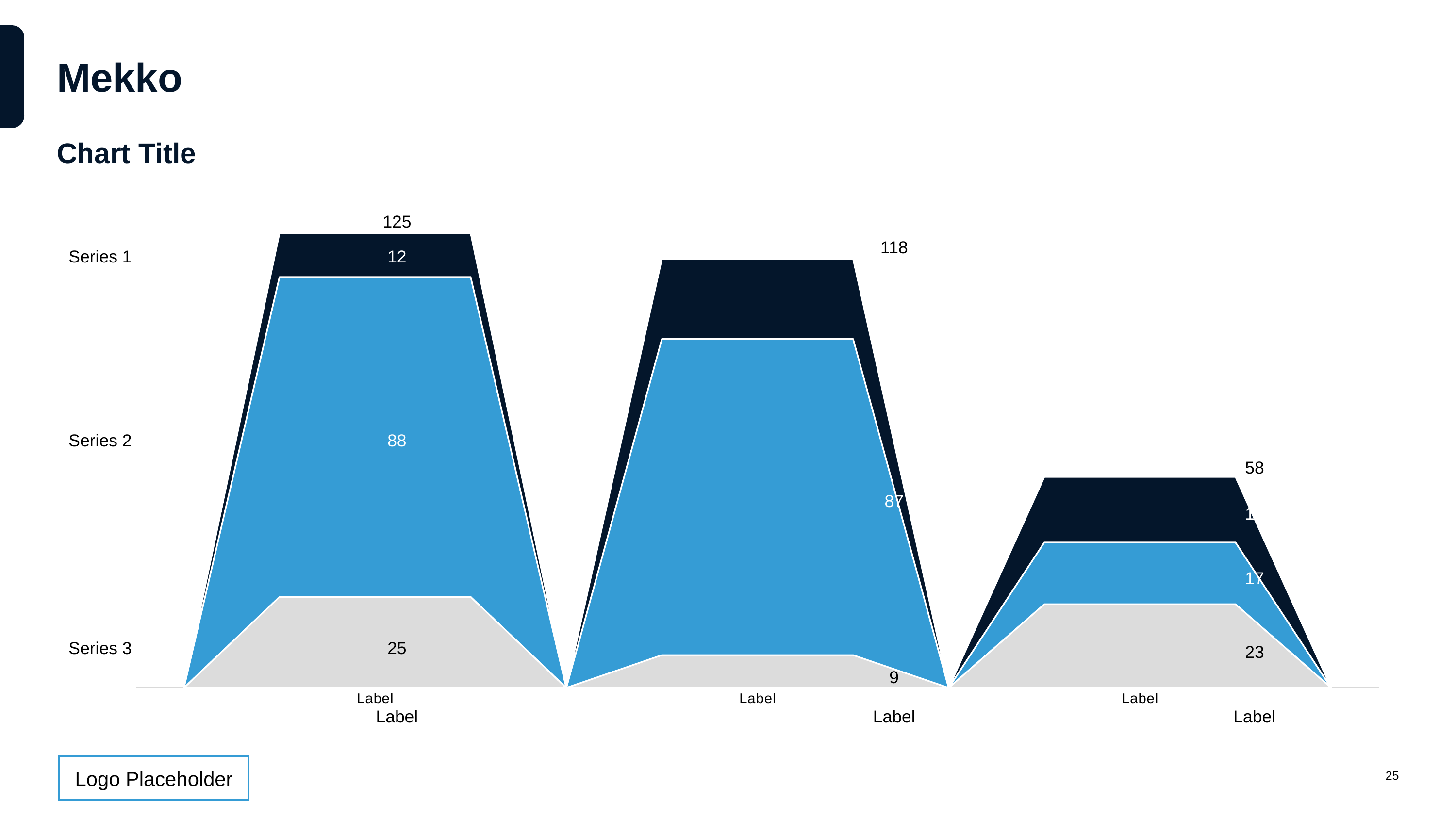
What is the Series 1 value in the left-hand bar? 12 What is the Series 3 value in the right-hand bar? 23 What is the total value shown above the right-hand bar? 58 Which bar has the lowest total: left, middle or right? right What is the difference between the totals of the left-hand bar and the middle bar? 7 What is the Series 2 value in the left-hand bar? 88 How many bars (categories) are plotted in the chart? 3 What is the Series 3 value in the left-hand bar? 25 What is the total value shown above the middle bar? 118 What is the total value shown above the left-hand bar? 125 Which bar has the highest total: left, middle or right? left What is the Series 3 value in the middle bar? 9